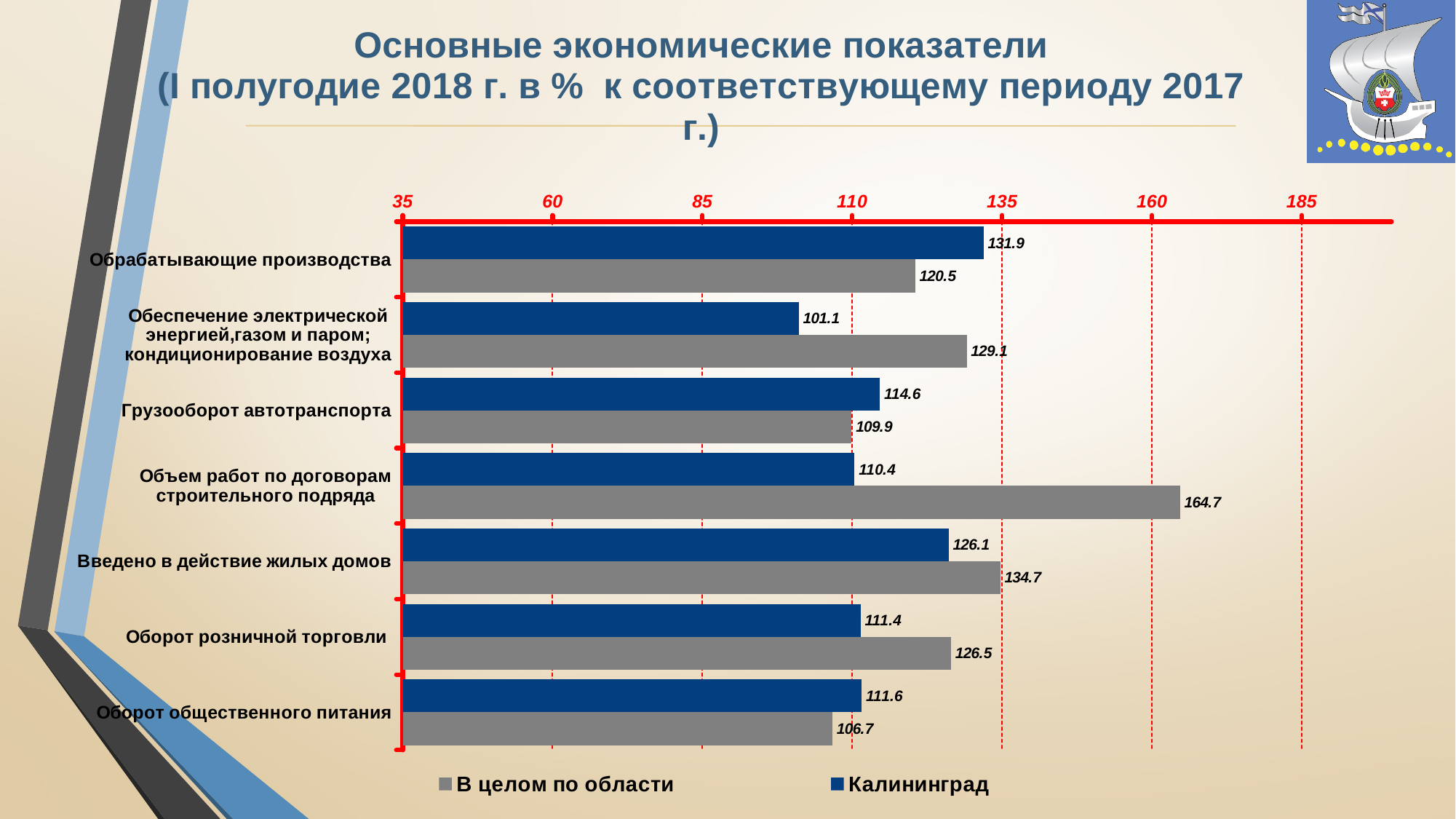
Which colour represents the Калининград series in the chart? blue What is the value for Калининград for Обеспечение электрической энергией, газом и паром; кондиционирование воздуха? 101.1 Which category has the highest value for В целом по области? Объем работ по договорам строительного подряда Is the value for В целом по области for Введено в действие жилых домов greater or less than 135? less What is the difference between the В целом по области and Калининград values for Объем работ по договорам строительного подряда? 54.3 Which category has the lowest value for Калининград? Обеспечение электрической энергией, газом и паром; кондиционирование воздуха For Оборот общественного питания, which is larger: the value for Калининград or for В целом по области? Калининград What is the value for Калининград for Обрабатывающие производства? 131.9 What type of chart is shown on the slide? bar chart How many categories are shown on the chart? 7 What is the value for В целом по области for Объем работ по договорам строительного подряда? 164.7 How many series does the legend list? 2